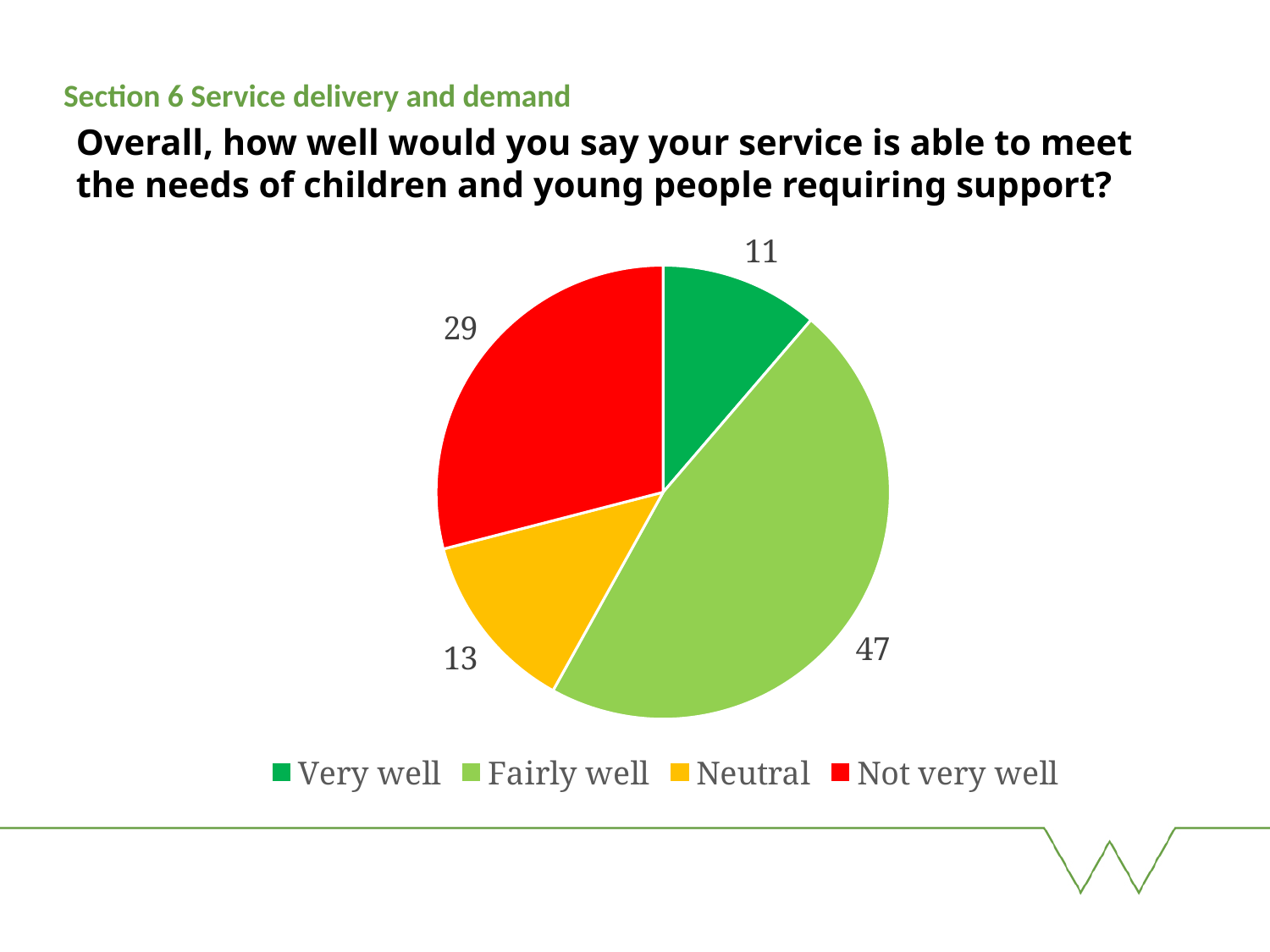
Which is larger, the value for Neutral or the value for Very well? Neutral What colour is the Not very well slice? Red What kind of chart is shown on the slide? Pie chart Which category has the smallest slice? Very well What is the total of all the slice values in the pie chart? 100 What is the value for Not very well? 29 What is the difference between the values for Fairly well and Not very well? 18 How many categories does the pie chart have? 4 Which category has the largest slice? Fairly well What is the value for Very well? 11 What is the value for Fairly well? 47 What is the value for Neutral? 13